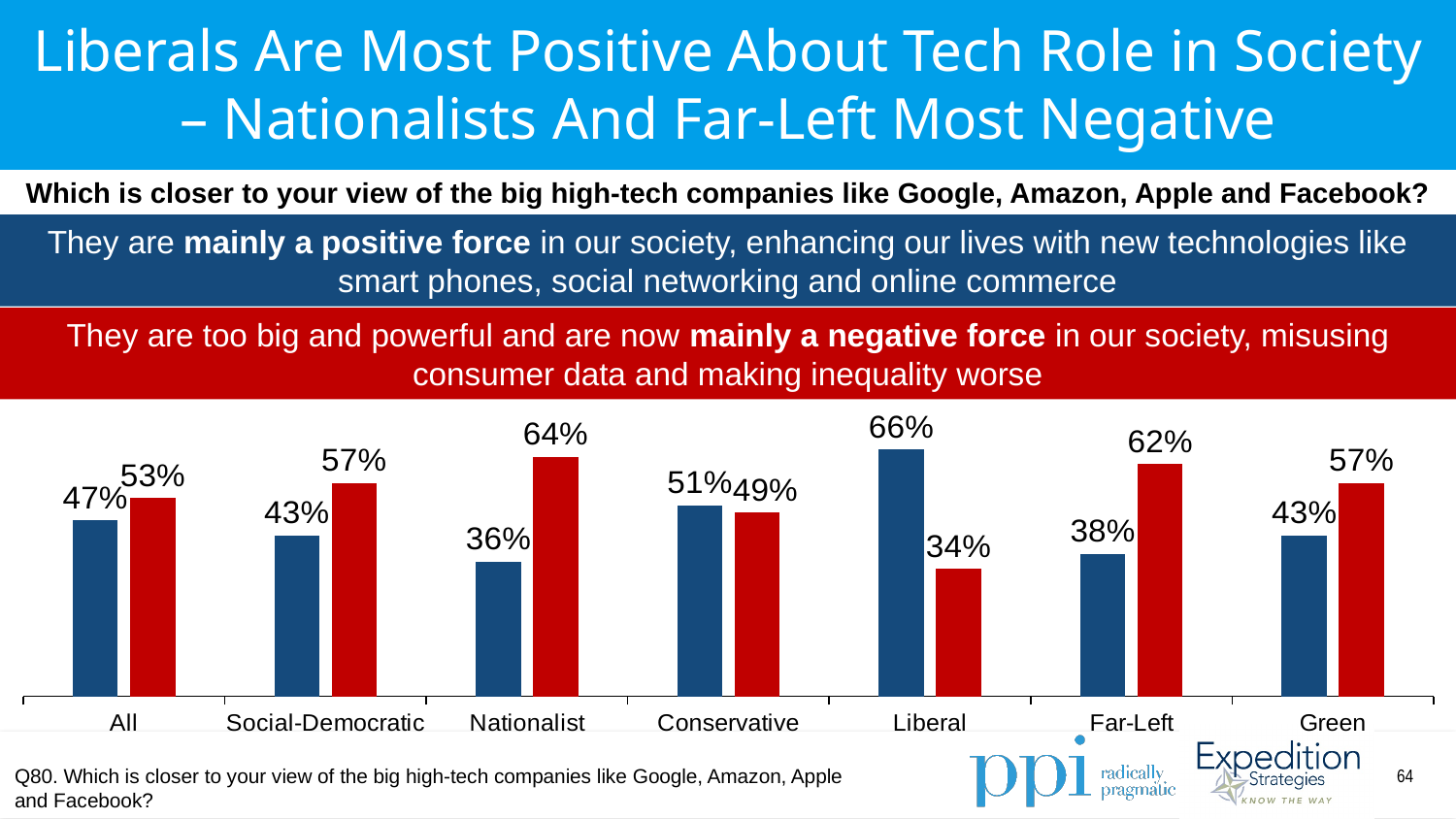
How many groups (categories) are shown along the x axis of the chart? 7 Which group has the lowest share saying big tech is mainly a negative force (red bar)? Liberal What is the value of the blue (positive force) bar for the All category? 47% Which group has the highest share saying big tech is mainly a positive force (blue bar)? Liberal What is the difference between the Liberal and Nationalist percentages saying big tech is mainly a positive force? 30 percentage points What percentage of Liberals say big tech companies are mainly a positive force (blue bar)? 66% For Conservatives, is the positive-force (blue) bar or the negative-force (red) bar larger? Positive force (blue), 51% vs 49% Which colour represents the view that big tech companies are mainly a negative force? Red What is the difference between the negative-force and positive-force percentages for Far-Left respondents? 24 percentage points What type of chart is shown on the slide? Bar chart What percentage of Nationalists say big tech companies are mainly a negative force (red bar)? 64% How many data series are plotted for each group in the chart? 2